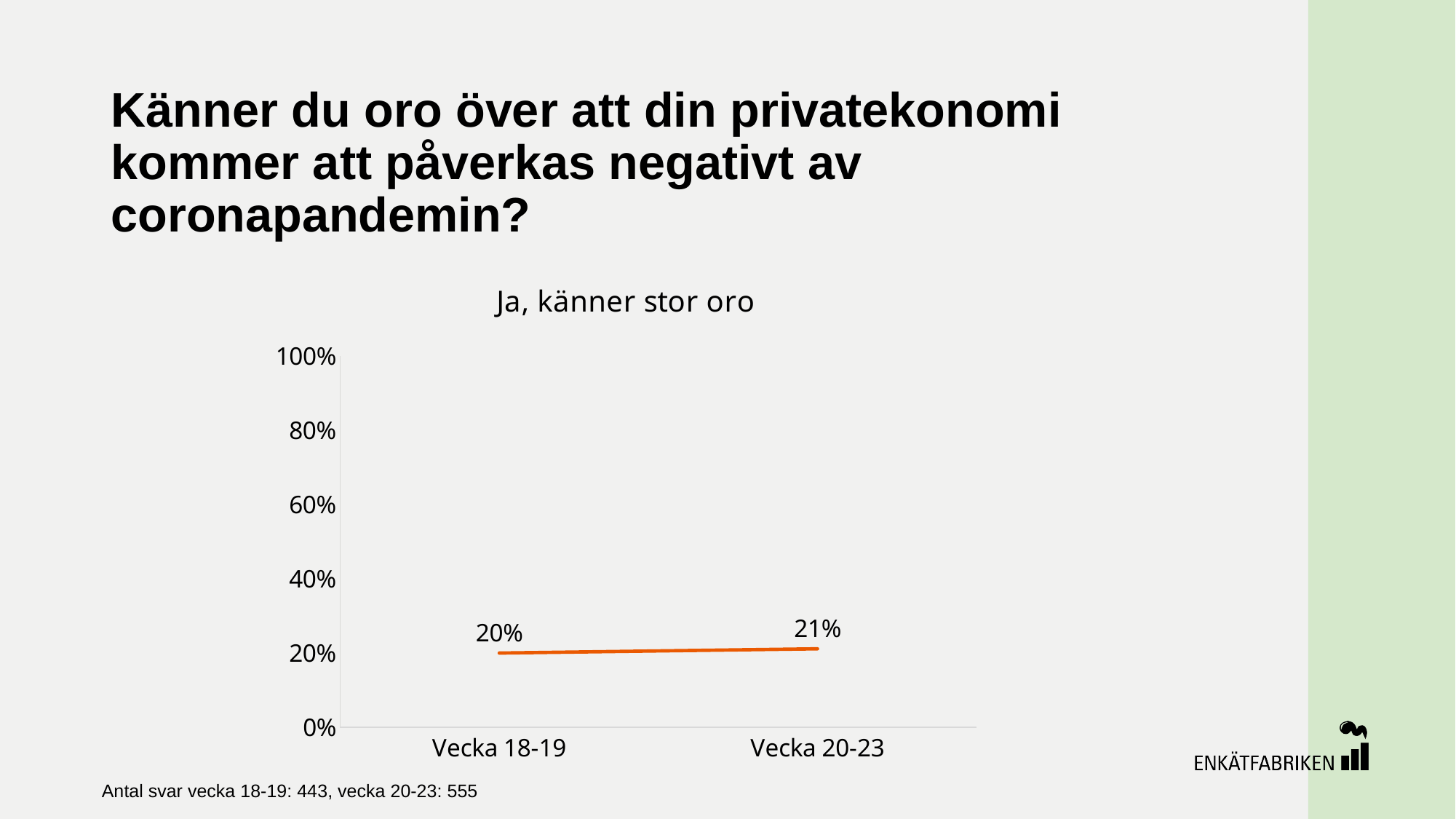
What is the difference between the values for Vecka 20-23 and Vecka 18-19? 1% What is the title of the chart? Ja, känner stor oro What colour is the line in the chart? orange How many categories are shown on the x axis? 2 Do the values rise or fall from Vecka 18-19 to Vecka 20-23? rise Is the value for Vecka 20-23 greater or less than 40%? less What kind of chart is shown on the slide? line chart What is the value for Vecka 20-23? 21% Which category has the highest value? Vecka 20-23 What is the value for Vecka 18-19? 20% Which category has the lowest value? Vecka 18-19 Which is larger, the value for Vecka 18-19 or Vecka 20-23? Vecka 20-23